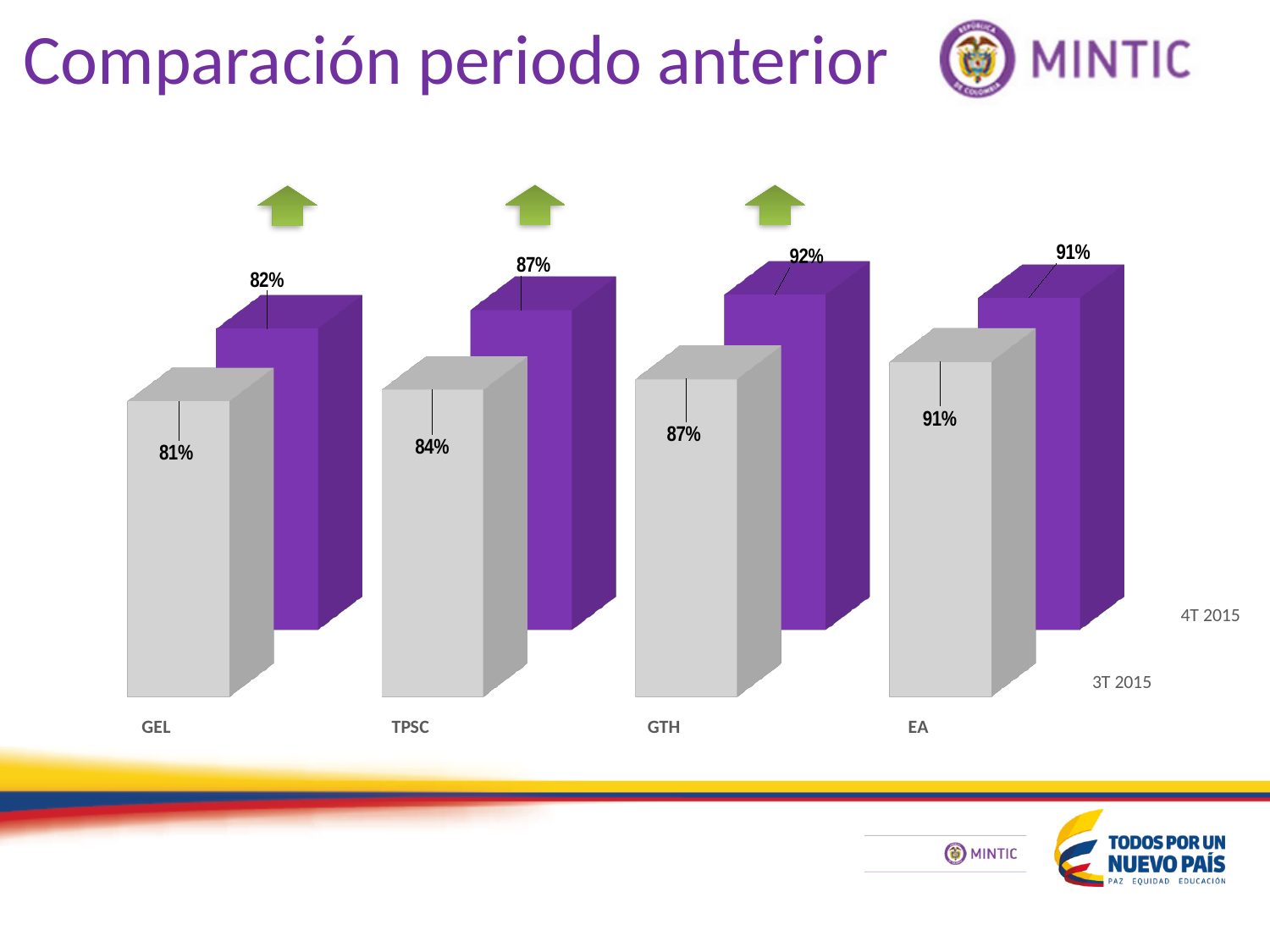
What is the value for EA in 3T 2015? 91% What is the value for GTH in 4T 2015? 92% Which category has the highest value in 4T 2015? GTH Which is larger for GEL, the 3T 2015 value or the 4T 2015 value? 4T 2015 What is the value for TPSC in 4T 2015? 87% What is the value for GEL in 3T 2015? 81% What is the difference between the 4T 2015 and 3T 2015 values for TPSC? 3% Which category has the lowest value in 3T 2015? GEL How many categories are shown on the x axis? 4 How many series does the chart show? 2 What is the difference between the 4T 2015 and 3T 2015 values for GTH? 5% What kind of chart is shown on the slide? Bar chart